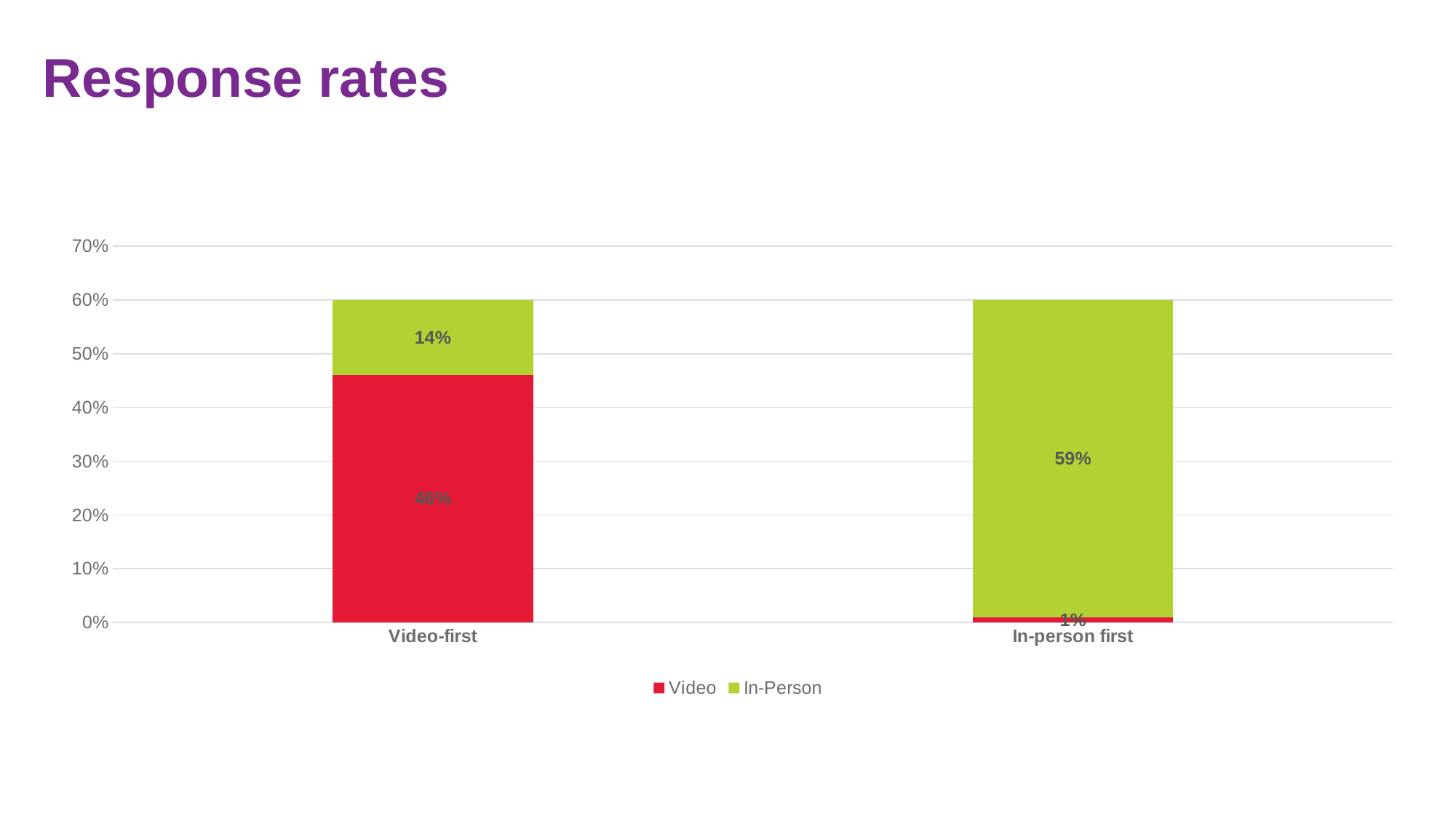
Which category has the higher Video value, Video-first or In-person first? Video-first How many series does the legend list? 2 How many categories are shown on the x axis? 2 What is the In-Person value for the In-person first category? 59% What is the Video value for the Video-first category? 46% Which category has the lowest In-Person value? Video-first What is the In-Person value for the Video-first category? 14% What kind of chart is shown on the slide? Stacked bar chart What is the Video value for the In-person first category? 1% What is the difference between the In-Person values for In-person first and Video-first? 45% What is the total of the stacked bar for Video-first? 60% What is the total of the stacked bar for In-person first? 60%